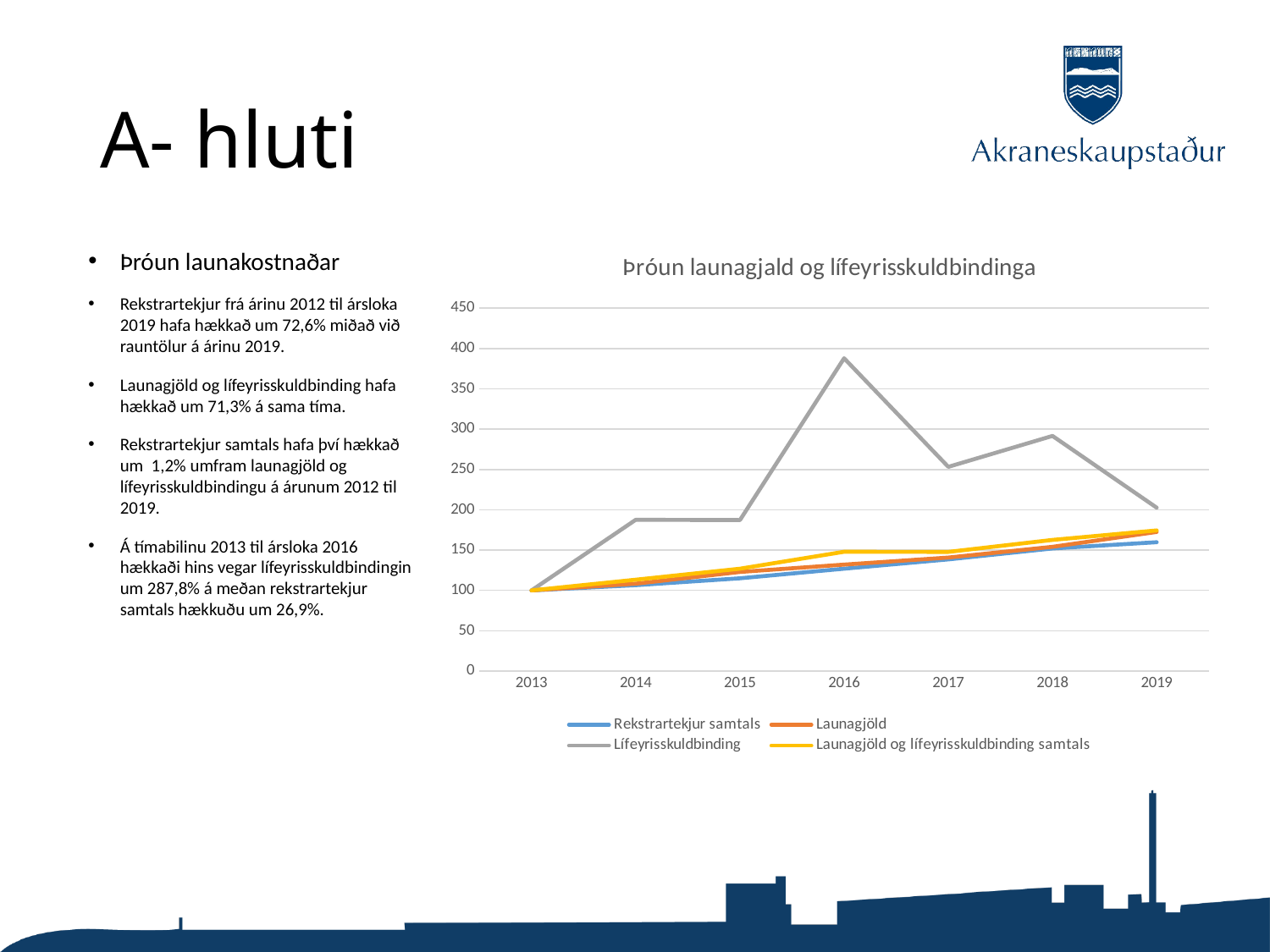
Is the value for Lífeyrisskuldbinding in 2016 greater or less than 350? greater Is the value for Rekstrartekjur samtals in 2019 greater or less than 200? less In which year does the Lífeyrisskuldbinding series reach its highest value? 2016 What is the title of the chart? Þróun launagjald og lífeyrisskuldbindinga How many series does the chart legend list? 4 Which series is shown in grey in the chart? Lífeyrisskuldbinding What kind of chart is shown on the slide? line chart Which series is higher in 2018, Lífeyrisskuldbinding or Launagjöld? Lífeyrisskuldbinding How many years are shown on the x axis of the chart? 7 Is the value for Lífeyrisskuldbinding in 2019 greater or less than 250? less Does the Rekstrartekjur samtals series rise or fall from 2013 to 2019? rise